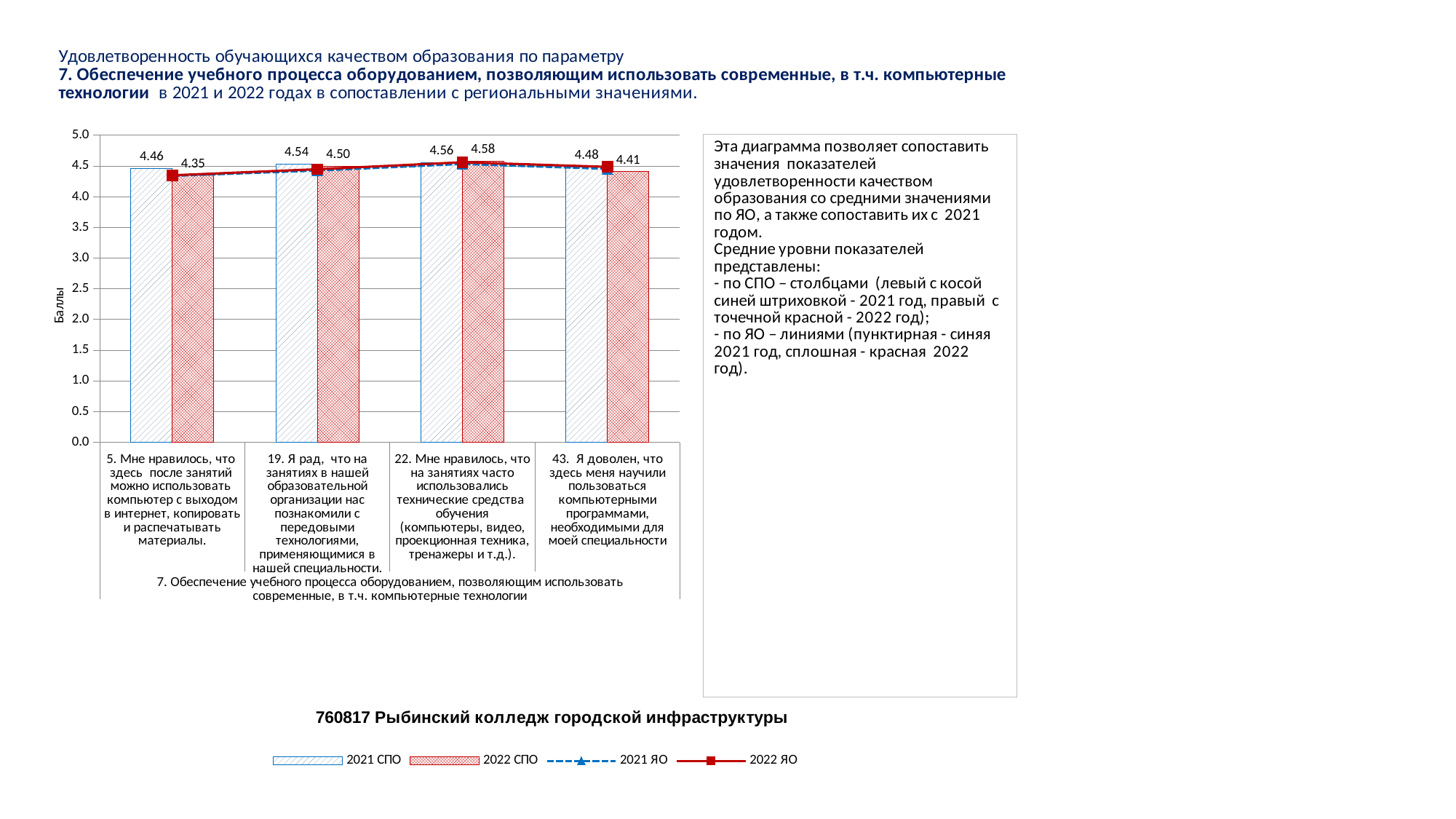
What is the value of 2022 СПО for question 22 ("Мне нравилось, что на занятиях часто использовались технические средства обучения...")? 4.58 What kind of chart is this? combination bar and line chart For which question is the 2022 СПО value the highest? 22 Which is larger for question 22: the 2021 СПО value or the 2022 СПО value? 2022 СПО What is the value of 2021 СПО for question 5 ("Мне нравилось, что здесь после занятий можно использовать компьютер...")? 4.46 Is the 2022 ЯО line value for question 5 greater or less than 4.0? greater How many question categories are shown on the x axis? 4 What is the difference between the 2021 СПО and 2022 СПО values for question 5? 0.11 What is the label of the vertical axis? Баллы For which question is the 2022 СПО value the lowest? 5 How many series does the legend list? 4 What is the value of 2022 СПО for question 43 ("Я доволен, что здесь меня научили пользоваться компьютерными программами...")? 4.41